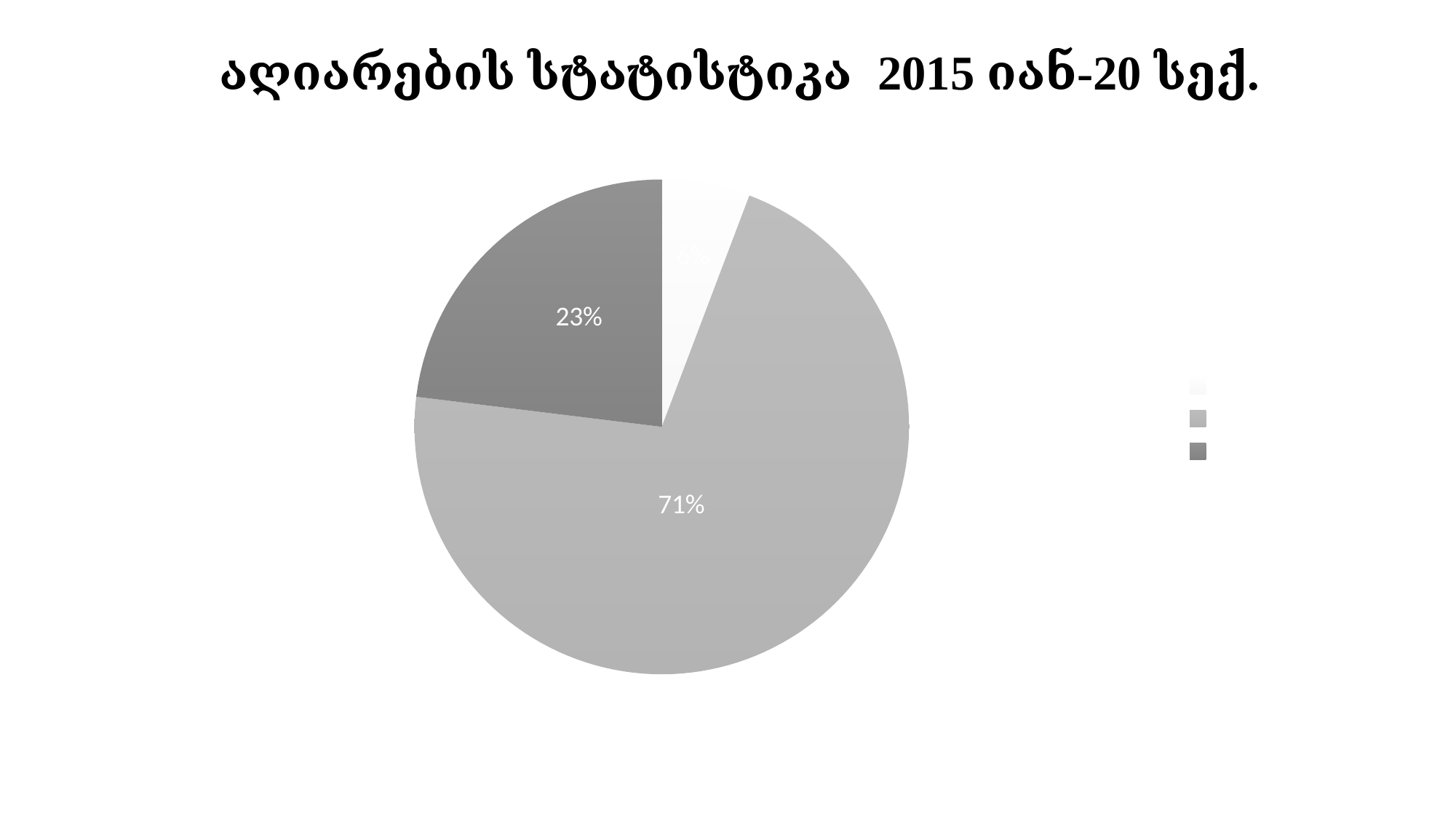
What is the difference in percentage points between the largest slice (71%) and the dark grey slice (23%)? 48 What share does the medium grey slice of the pie chart represent? 71% What is the share of the largest slice in the pie chart? 71% What is the share of the smallest slice in the pie chart? 6% What is the difference in percentage points between the dark grey slice (23%) and the lightest slice (6%)? 17 What kind of chart is shown on the slide? pie chart What year is mentioned in the title of the chart slide? 2015 What share does the dark grey slice of the pie chart represent? 23% How many entries does the legend of the pie chart list? 3 Which slice is larger in the pie chart: the dark grey slice or the lightest (white) slice? the dark grey slice What share does the lightest (white) slice of the pie chart represent? 6% How many slices does the pie chart have? 3